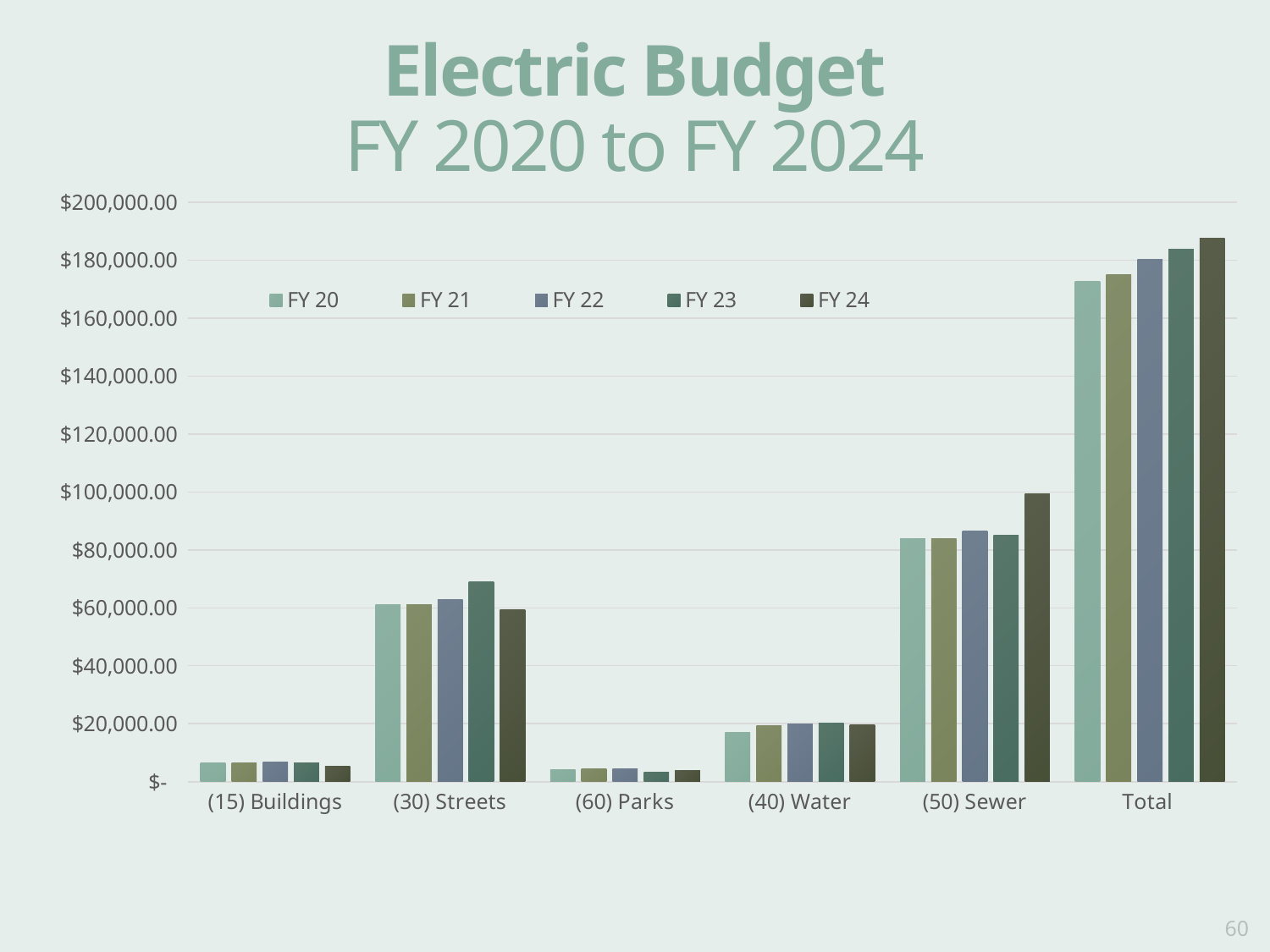
Do the Total values rise or fall from FY 20 to FY 24? rise How many categories are shown on the x axis? 6 Is the FY 24 value for (50) Sewer greater or less than $80,000.00? greater Is the FY 24 value for Total greater or less than $180,000.00? greater Which category has the lowest FY 23 value? (60) Parks How many series does the legend list? 5 Is the FY 20 value for (40) Water greater or less than $20,000.00? less Excluding Total, which category has the highest FY 24 value? (50) Sewer What kind of chart is shown on the slide? Bar chart For (30) Streets, which is larger: the FY 23 value or the FY 24 value? FY 23 Which category has the highest FY 24 value? Total